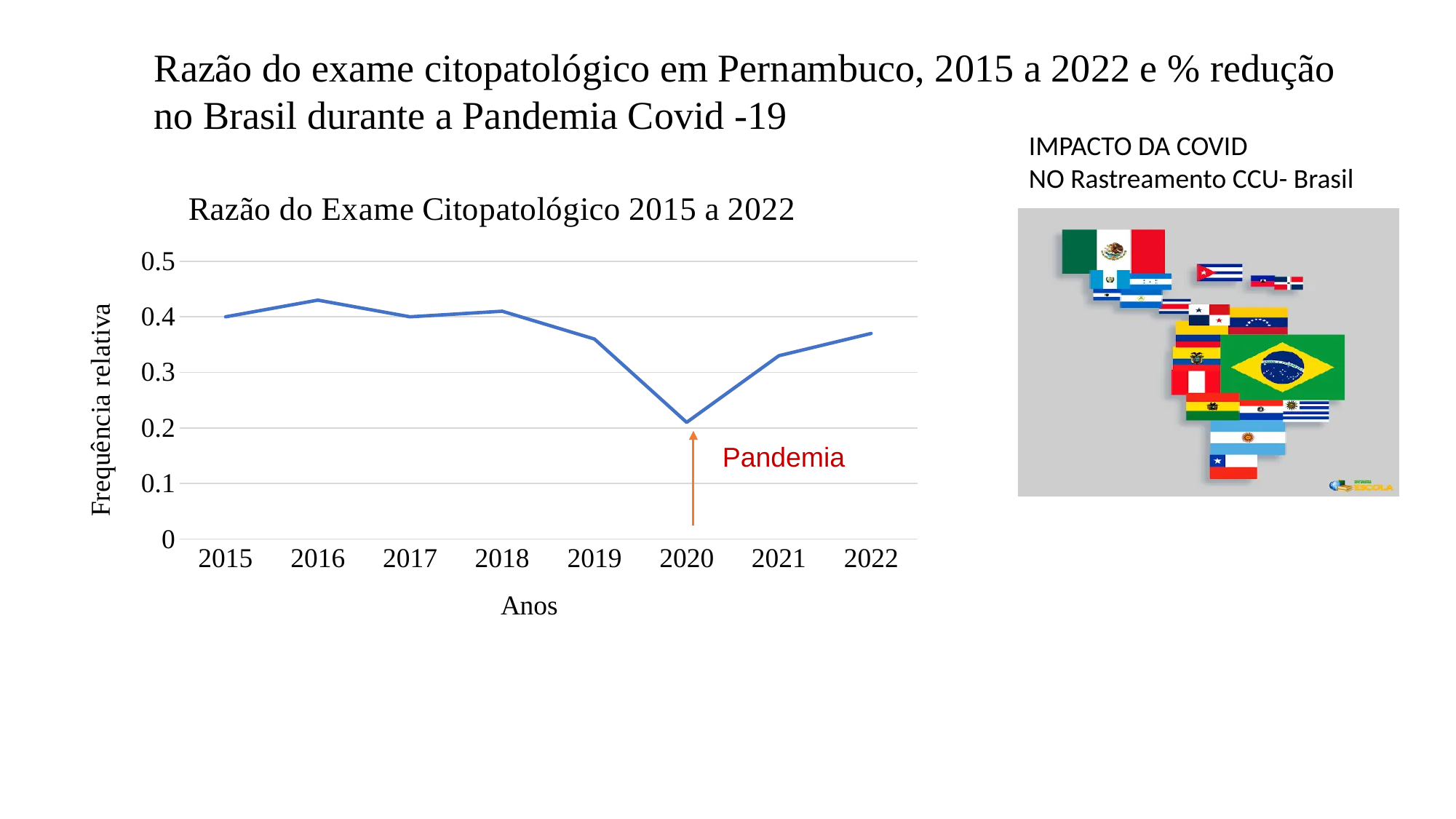
What is the label of the y axis of the chart? Frequência relativa Which year has the larger value, 2021 or 2022? 2022 Do the values rise or fall from 2020 to 2022? rise Which year has the lowest value in the chart? 2020 What is the title of the chart? Razão do Exame Citopatológico 2015 a 2022 Which year has the larger value, 2019 or 2020? 2019 How many years are plotted on the x axis of the chart? 8 Is the value for 2016 greater or less than 0.4? greater Which year has the highest value in the chart? 2016 Is the value for 2019 greater or less than 0.4? less Is the value for 2020 greater or less than 0.3? less What kind of chart is shown on the slide? line chart